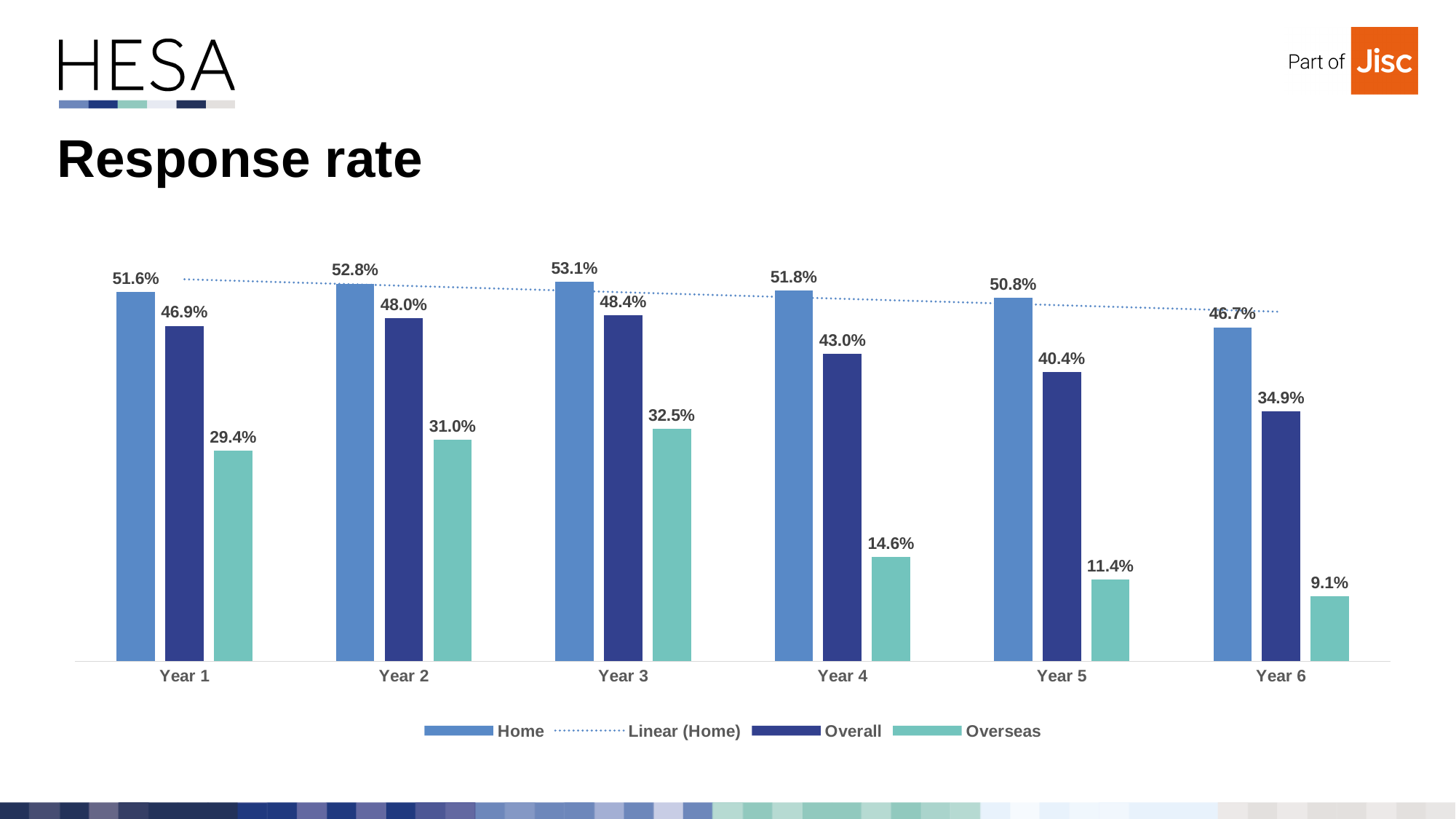
How many years are shown on the x axis? 6 What is the Overseas response rate for Year 6? 9.1% What is the Home response rate for Year 3? 53.1% Which year has the lowest Overseas response rate? Year 6 What kind of chart is this? Bar chart What is the difference between the Home and Overseas response rates in Year 1? 22.2% How many entries does the legend list? 4 What is the title of the chart? Response rate Does the Overseas response rate rise or fall from Year 3 to Year 6? Fall Which is larger, the Overall response rate in Year 2 or in Year 5? Year 2 What is the Overall response rate for Year 4? 43.0% Which year has the highest Home response rate? Year 3